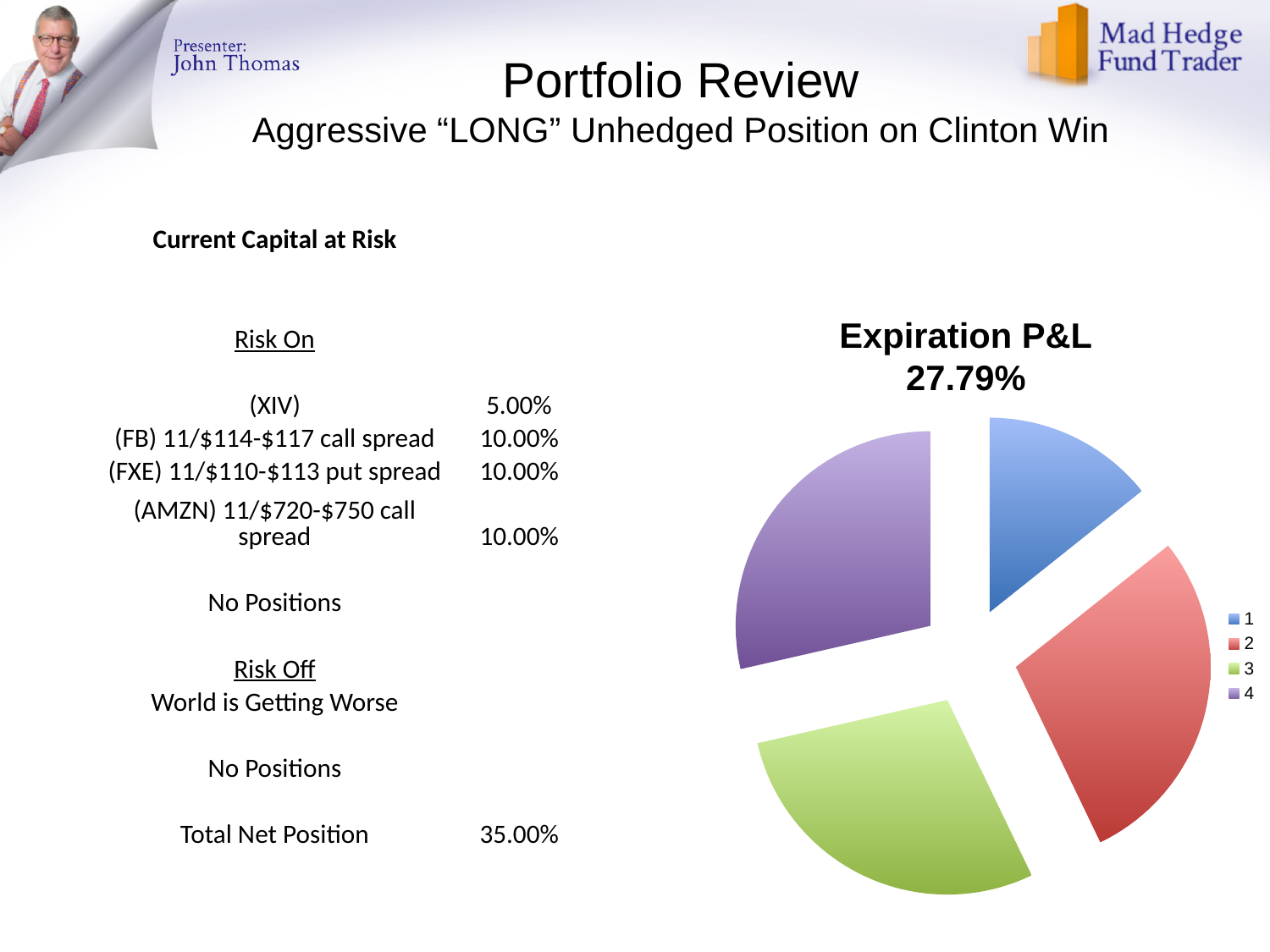
What is the title of the pie chart? Expiration P&L 27.79% Which slice of the pie chart is the smallest? 1 What are the legend labels of the pie chart? 1, 2, 3, 4 What colour is slice 1 in the pie chart? blue How many slices does the pie chart have? 4 How many entries does the pie chart's legend list? 4 Which is larger in the pie chart, slice 1 or slice 2? 2 What kind of chart is shown on the slide? pie chart Which is larger in the pie chart, slice 3 or slice 1? 3